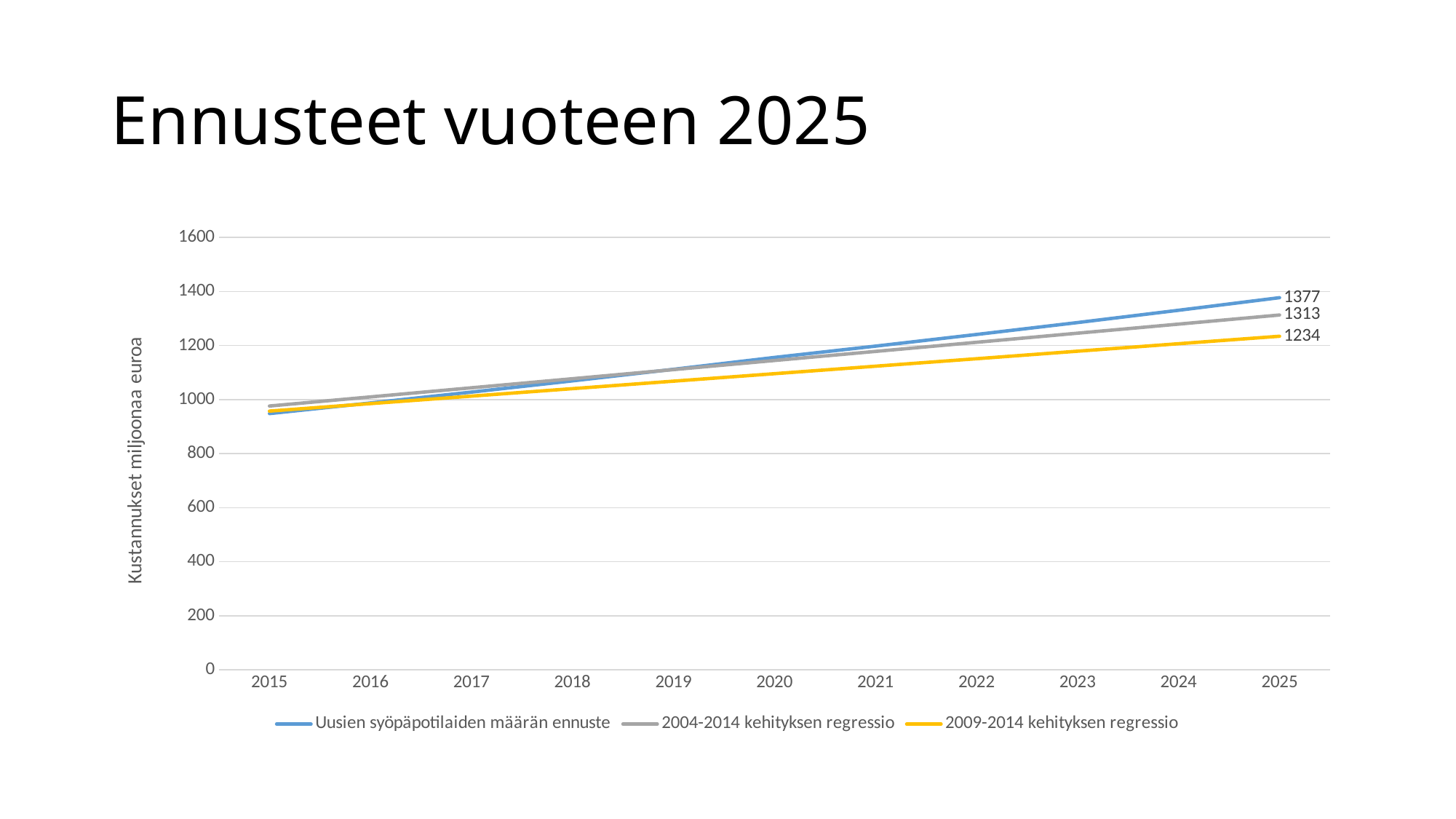
In 2025, which is larger: 'Uusien syöpäpotilaiden määrän ennuste' or '2004-2014 kehityksen regressio'? Uusien syöpäpotilaiden määrän ennuste What is the value for 'Uusien syöpäpotilaiden määrän ennuste' in 2025? 1377 Which series has the highest value in 2025? Uusien syöpäpotilaiden määrän ennuste How many years are shown on the x axis? 11 What kind of chart is shown on the slide? line chart How many series does the legend list? 3 What is the difference between the 2025 values of '2004-2014 kehityksen regressio' and '2009-2014 kehityksen regressio'? 79 What is the value for '2004-2014 kehityksen regressio' in 2025? 1313 What is the value for '2009-2014 kehityksen regressio' in 2025? 1234 Is the value for '2009-2014 kehityksen regressio' in 2015 greater or less than 1000? less What is the difference between the 2025 values of 'Uusien syöpäpotilaiden määrän ennuste' and '2009-2014 kehityksen regressio'? 143 Which series has the lowest value in 2025? 2009-2014 kehityksen regressio